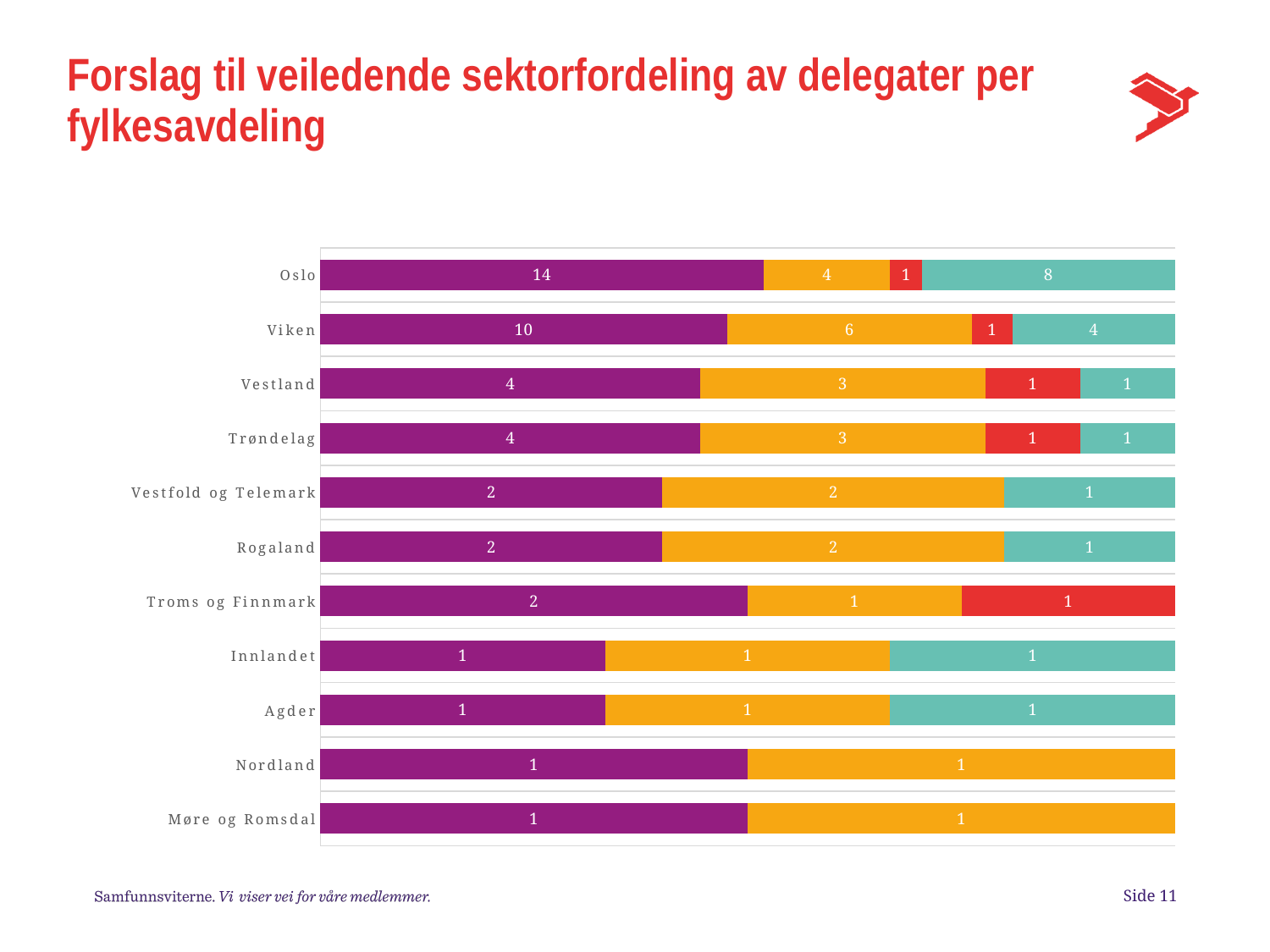
What is the total of all segments in the Vestland bar? 9 What is the total of all segments in the Viken bar? 21 Which fylkesavdeling has the highest total number of delegates? Oslo What is the total of all segments in the Oslo bar? 27 What kind of chart is shown on the slide? bar chart Which category is listed at the bottom of the chart? Møre og Romsdal Which is larger: the teal segment for Oslo or the teal segment for Viken? Oslo What is the value of the teal segment for Oslo? 8 What is the value of the purple segment for Oslo? 14 What is the value of the orange segment for Viken? 6 What is the difference between the purple segment for Oslo and the purple segment for Viken? 4 How many fylkesavdelinger (categories) are listed on the chart? 11